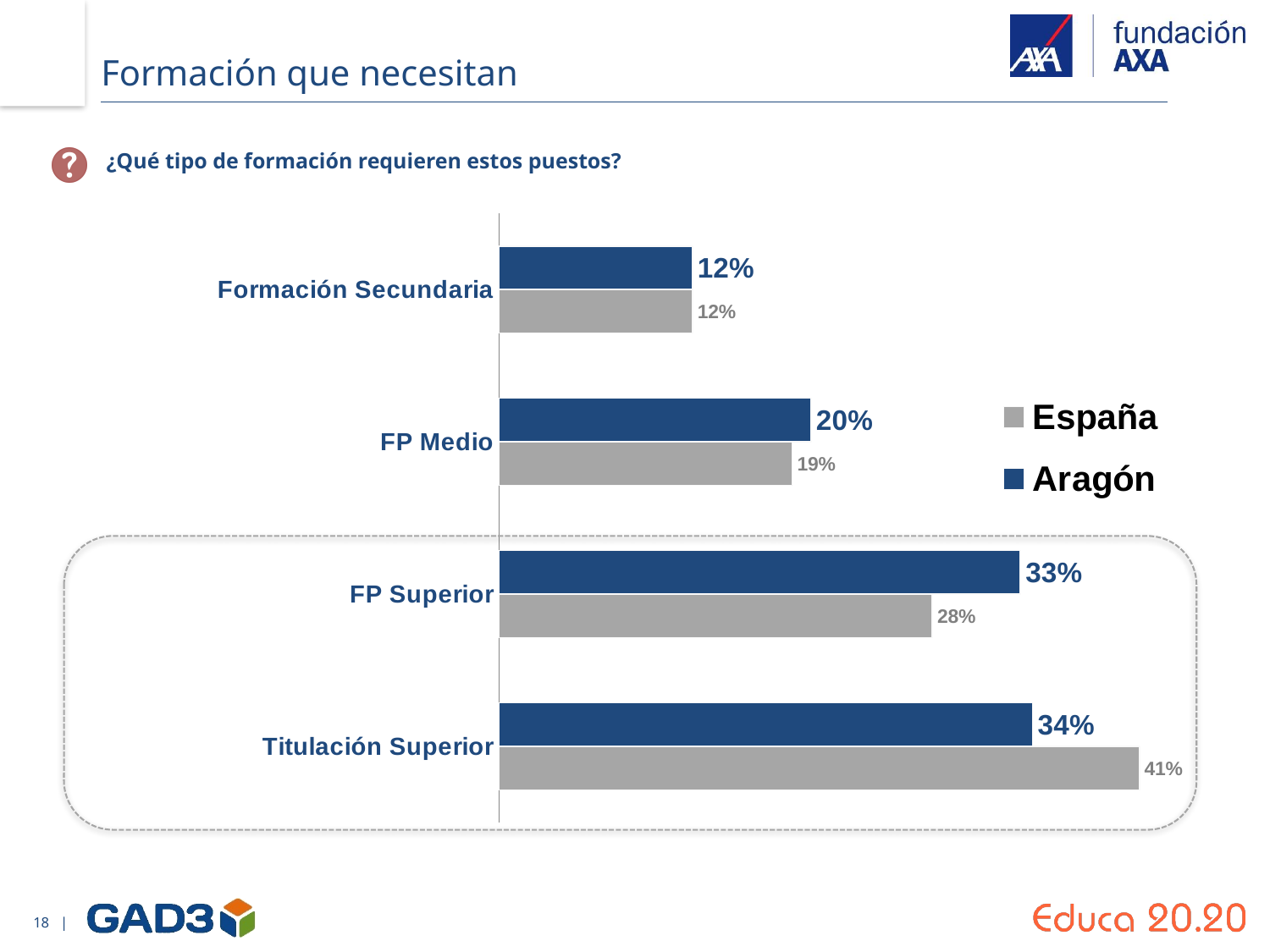
What is the difference between the España and Aragón values for Titulación Superior? 7% Which is larger for FP Medio, the Aragón value or the España value? Aragón How many categories are shown on the chart? 4 What kind of chart is shown on the slide? Bar chart Which category has the lowest value for Aragón? Formación Secundaria What is the value for Aragón in the FP Superior category? 33% Which colour represents the España series in the legend? Grey How many series does the legend list? 2 What is the value for España in the Titulación Superior category? 41% What is the difference between the Aragón and España values for FP Superior? 5% Which category has the highest value for España? Titulación Superior What is the value for España in the FP Medio category? 19%